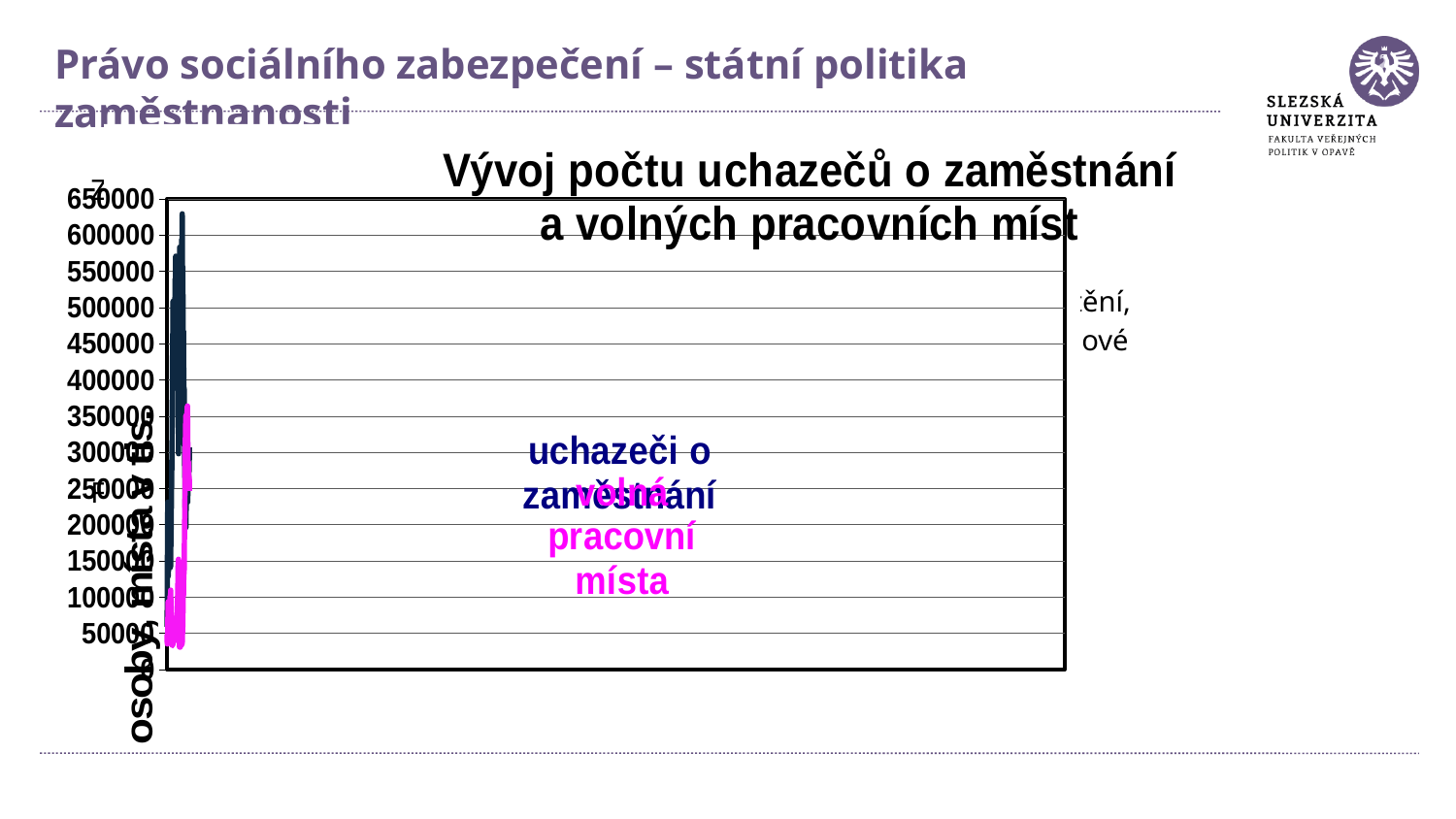
What kind of chart is shown on the slide? line chart Is the highest value of the uchazeči o zaměstnání series greater or less than 500000? greater Which series is drawn in magenta? volná pracovní místa What is the title of the chart on the slide? Vývoj počtu uchazečů o zaměstnání a volných pracovních míst Is the highest value of the volná pracovní místa series greater or less than 400000? less How many data series does the chart show? 2 What is the highest value shown on the vertical axis? 650000 Which series reaches higher values, uchazeči o zaměstnání or volná pracovní místa? uchazeči o zaměstnání